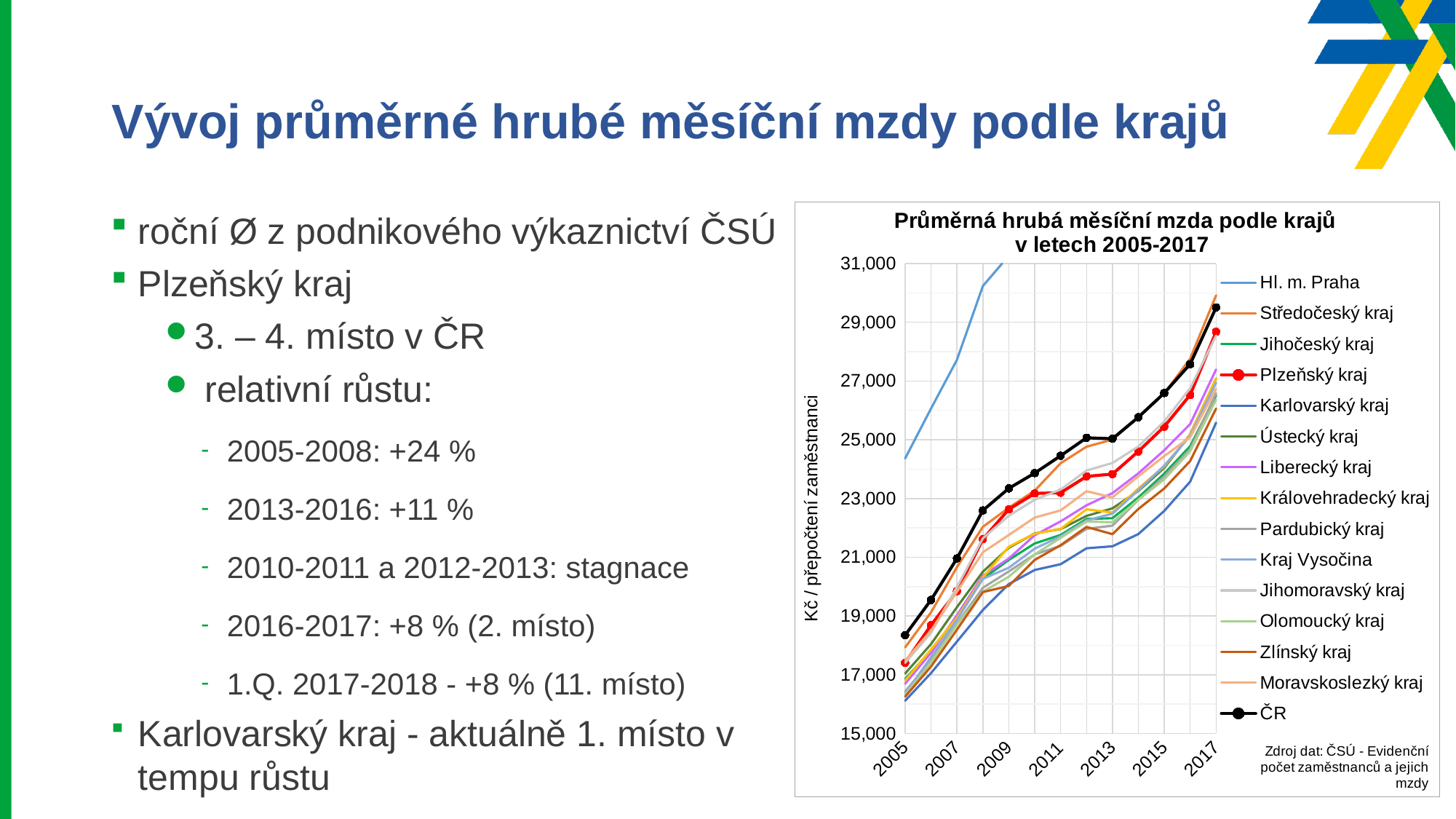
How many series does the chart legend list? 15 Is the value for ČR in 2005 greater or less than 19,000? less Is the value for Hl. m. Praha in 2005 greater or less than 23,000? greater What is the label of the vertical axis of the chart? Kč / přepočtení zaměstnanci Is the value for Karlovarský kraj in 2005 greater or less than 17,000? less What kind of chart is shown on the slide? line chart In 2013, which is higher: the value for ČR or the value for Plzeňský kraj? ČR Does the value for Plzeňský kraj rise or fall from 2005 to 2017? rise Which series has the highest value in 2005? Hl. m. Praha What is the title of the chart? Průměrná hrubá měsíční mzda podle krajů v letech 2005-2017